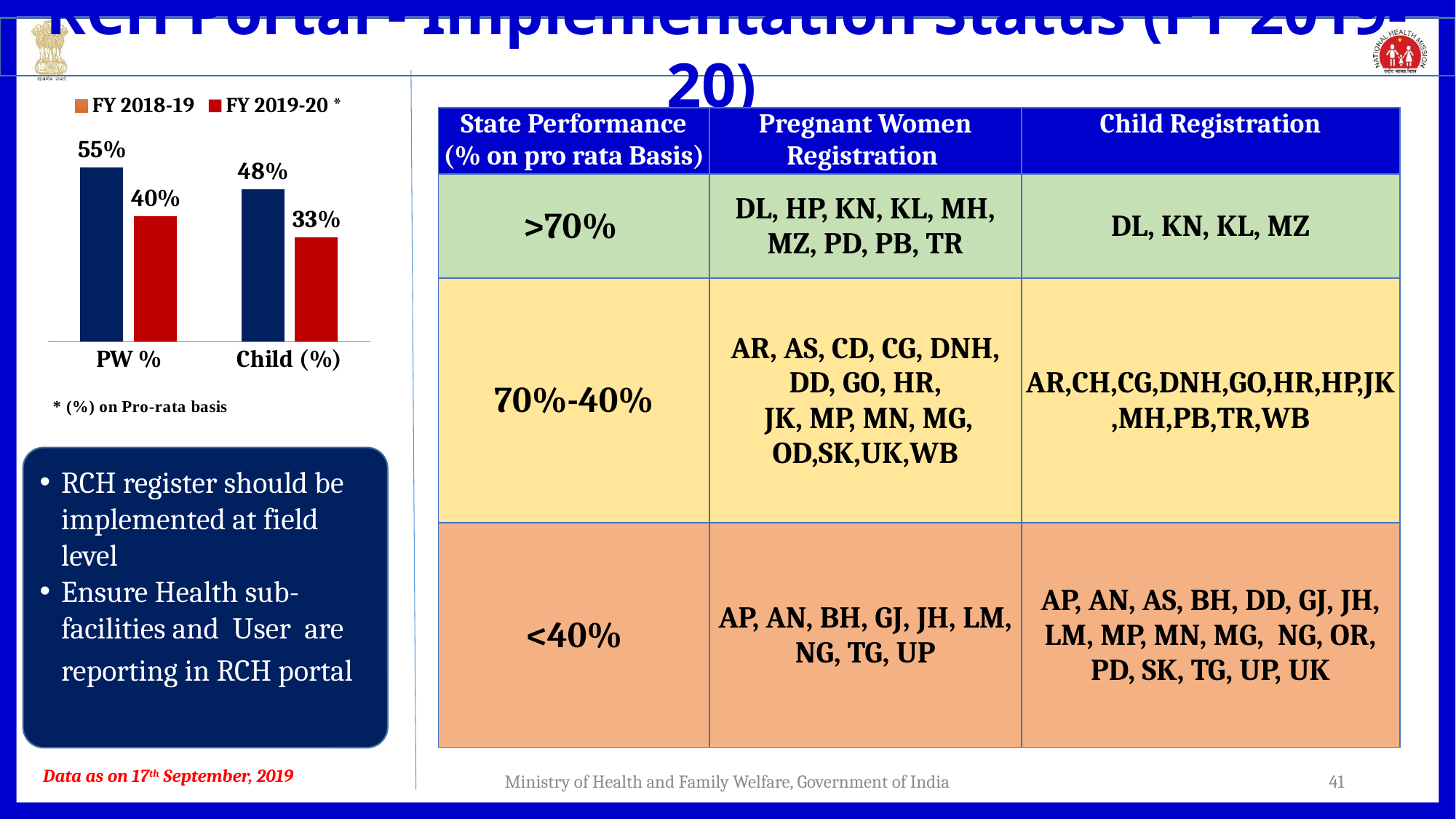
What kind of chart is shown on the slide? Bar chart Which category has the lowest FY 2019-20 value? Child (%) How many series does the chart legend list? 2 Which is larger, the FY 2019-20 value for PW % or the FY 2018-19 value for Child (%)? FY 2018-19 value for Child (%) What is the FY 2019-20 value for Child (%)? 33% How many categories are shown on the x axis of the chart? 2 What is the FY 2018-19 value for PW %? 55% What is the difference between the FY 2018-19 and FY 2019-20 values for PW %? 15% What is the difference between the FY 2018-19 and FY 2019-20 values for Child (%)? 15% What is the FY 2018-19 value for Child (%)? 48% What is the FY 2019-20 value for PW %? 40% Which category has the highest FY 2018-19 value? PW %